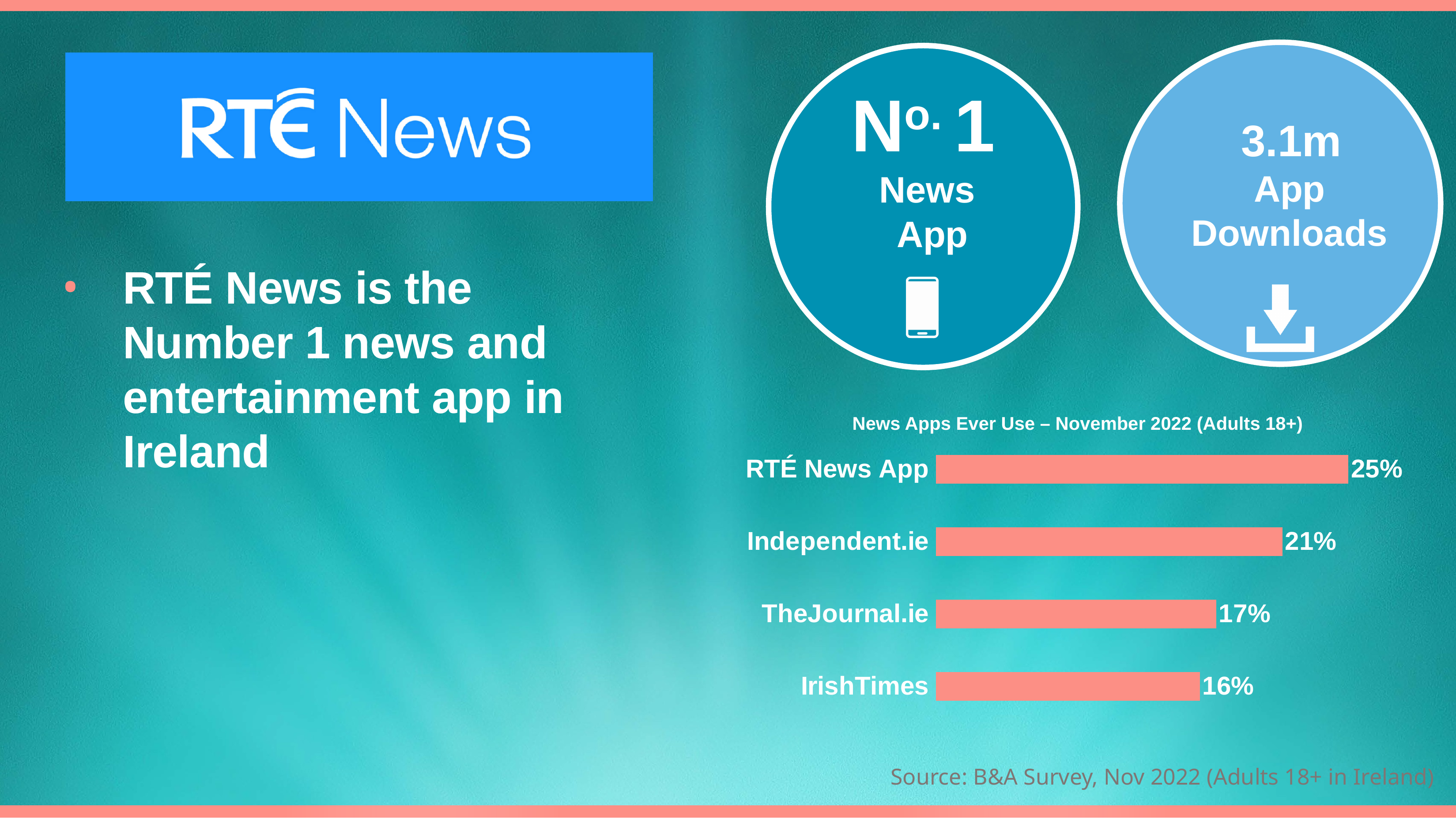
How many news apps are shown in the chart? 4 What is the value for RTÉ News App in the chart? 25% What is the value for TheJournal.ie in the chart? 17% Which has a larger value, TheJournal.ie or Independent.ie? Independent.ie Which news app has the lowest ever-use value in the chart? IrishTimes What is the title of the chart? News Apps Ever Use – November 2022 (Adults 18+) What is the difference between the values for Independent.ie and IrishTimes? 5% Which news app has the highest ever-use value in the chart? RTÉ News App What is the value for IrishTimes in the chart? 16% What kind of chart is shown on the slide? Bar chart What is the difference between the values for RTÉ News App and Independent.ie? 4% What is the value for Independent.ie in the chart? 21%